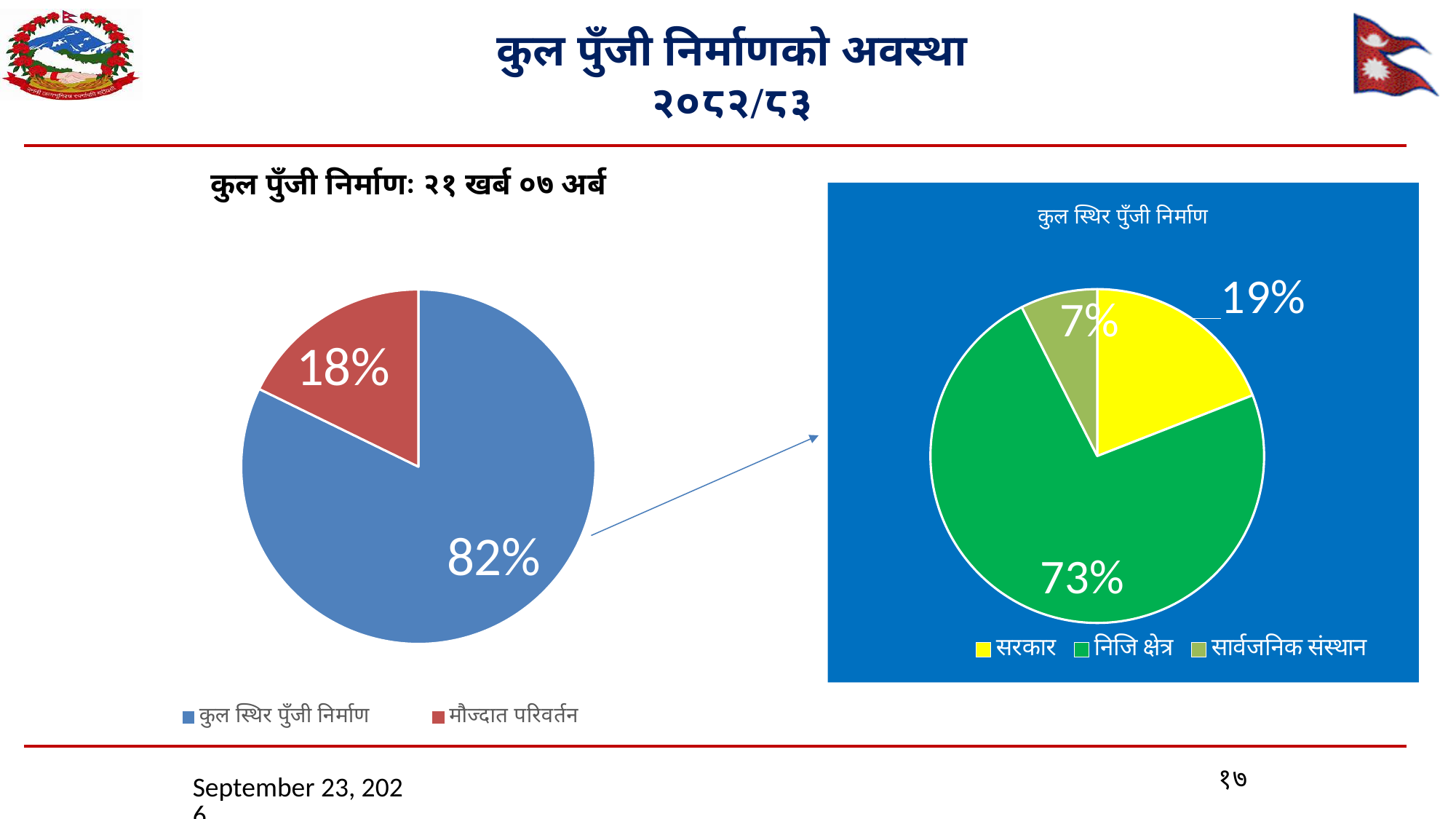
What kind of chart is the chart titled कुल स्थिर पुँजी निर्माण on the right? pie chart On the left pie chart, what share is shown for मौज्दात परिवर्तन? 18% On the right pie chart titled कुल स्थिर पुँजी निर्माण, what share is shown for सरकार? 19% On the right pie chart titled कुल स्थिर पुँजी निर्माण, what share is shown for सार्वजनिक संस्थान? 7% On the right pie chart titled कुल स्थिर पुँजी निर्माण, which category has the smallest slice? सार्वजनिक संस्थान On the right pie chart titled कुल स्थिर पुँजी निर्माण, how many categories does the legend list? 3 On the left pie chart, what is the difference in percentage points between the two slices? 64 On the left pie chart, which slice is the largest? कुल स्थिर पुँजी निर्माण On the right pie chart titled कुल स्थिर पुँजी निर्माण, which is larger: सरकार or सार्वजनिक संस्थान? सरकार How many slices does the left pie chart have? 2